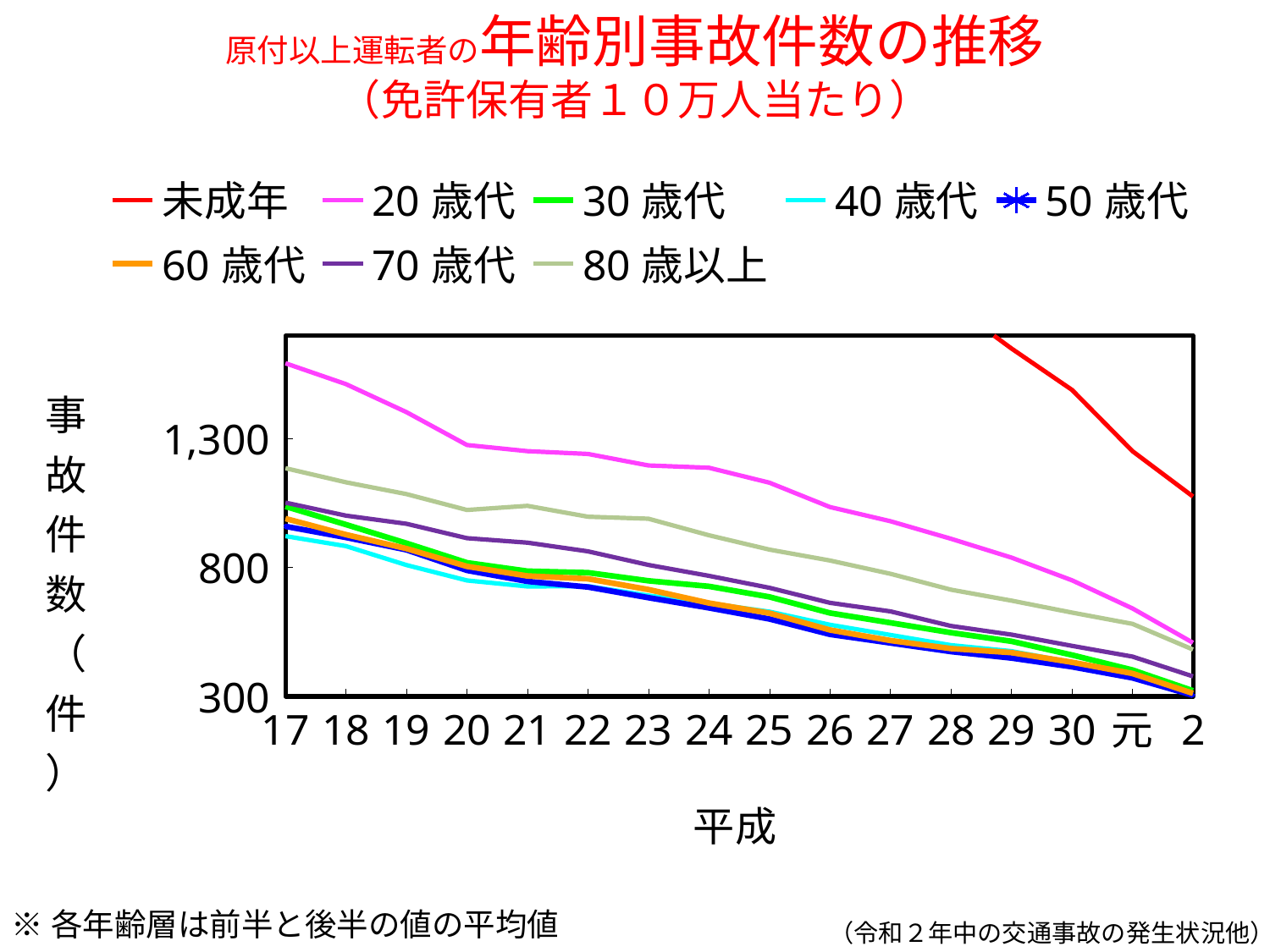
What kind of chart is shown on the slide? line chart Is the value for 20歳代 at 2 greater or less than 800? less Which is larger at 17, the value for 20歳代 or the value for 80歳以上? 20歳代 Is the value for 未成年 at 2 greater or less than 800? greater How many points are labelled along the x axis? 16 Which series has the highest value at 2? 未成年 What colour is the line for 未成年 in the legend? red Does the value for 20歳代 rise or fall from 17 to 2 along the x axis? fall Is the value for 80歳以上 at 17 greater or less than 1,300? less How many series does the legend list? 8 Does the value for 80歳以上 rise or fall from 17 to 2 along the x axis? fall